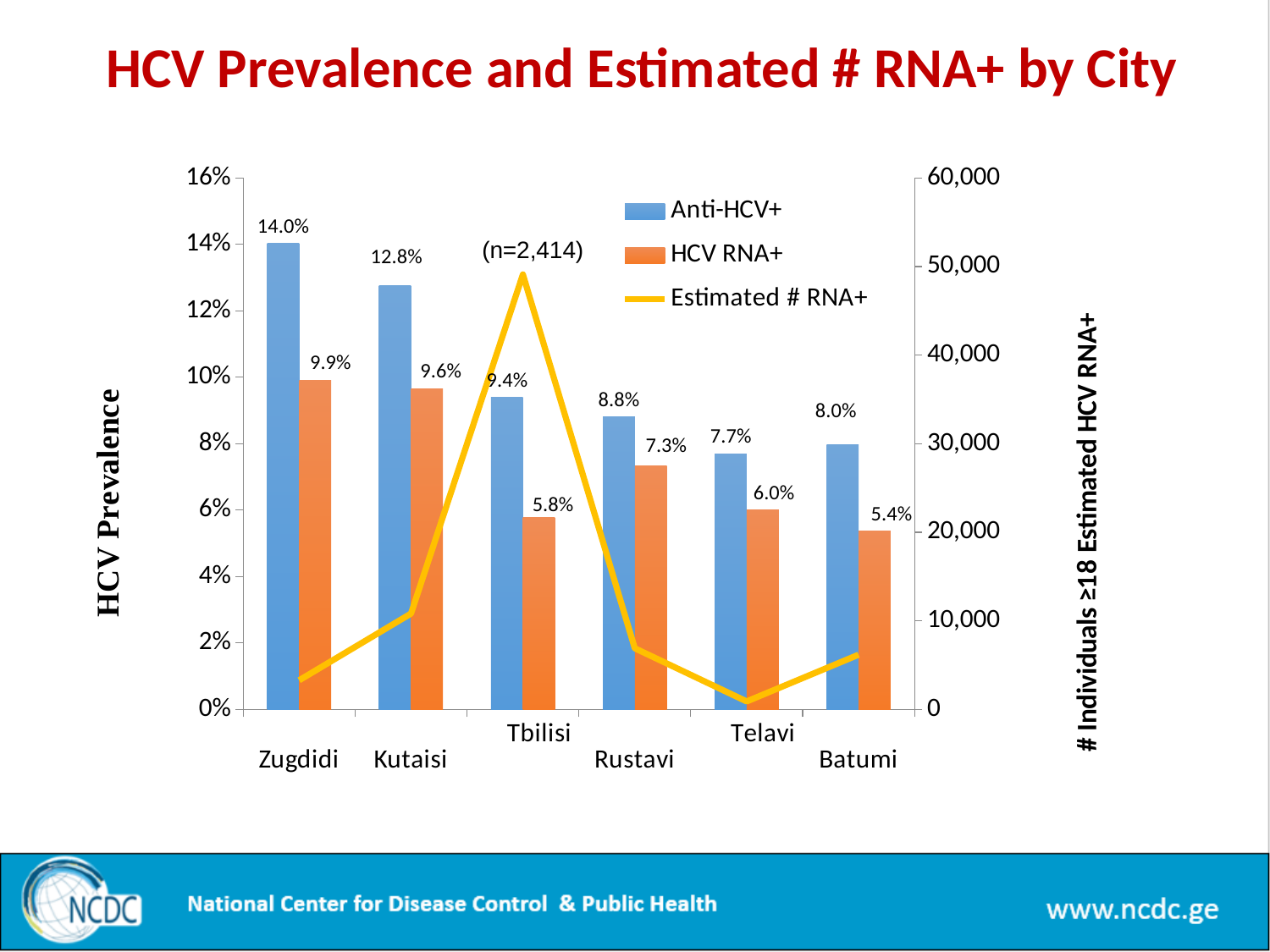
Which city has the highest Anti-HCV+ prevalence? Zugdidi Is the Estimated # RNA+ value for Telavi greater or less than 10,000? less Is the Estimated # RNA+ value for Tbilisi greater or less than 40,000? greater What is the HCV RNA+ prevalence for Batumi? 5.4% Which city has the lowest HCV RNA+ prevalence? Batumi How many cities are shown on the x axis? 6 Which is larger, the Anti-HCV+ prevalence in Telavi or in Batumi? Batumi What is the label of the left vertical axis? HCV Prevalence How many series does the legend list? 3 What is the Anti-HCV+ prevalence for Zugdidi? 14.0% What is the HCV RNA+ prevalence for Rustavi? 7.3% What is the difference between the Anti-HCV+ and HCV RNA+ prevalence in Tbilisi? 3.6%